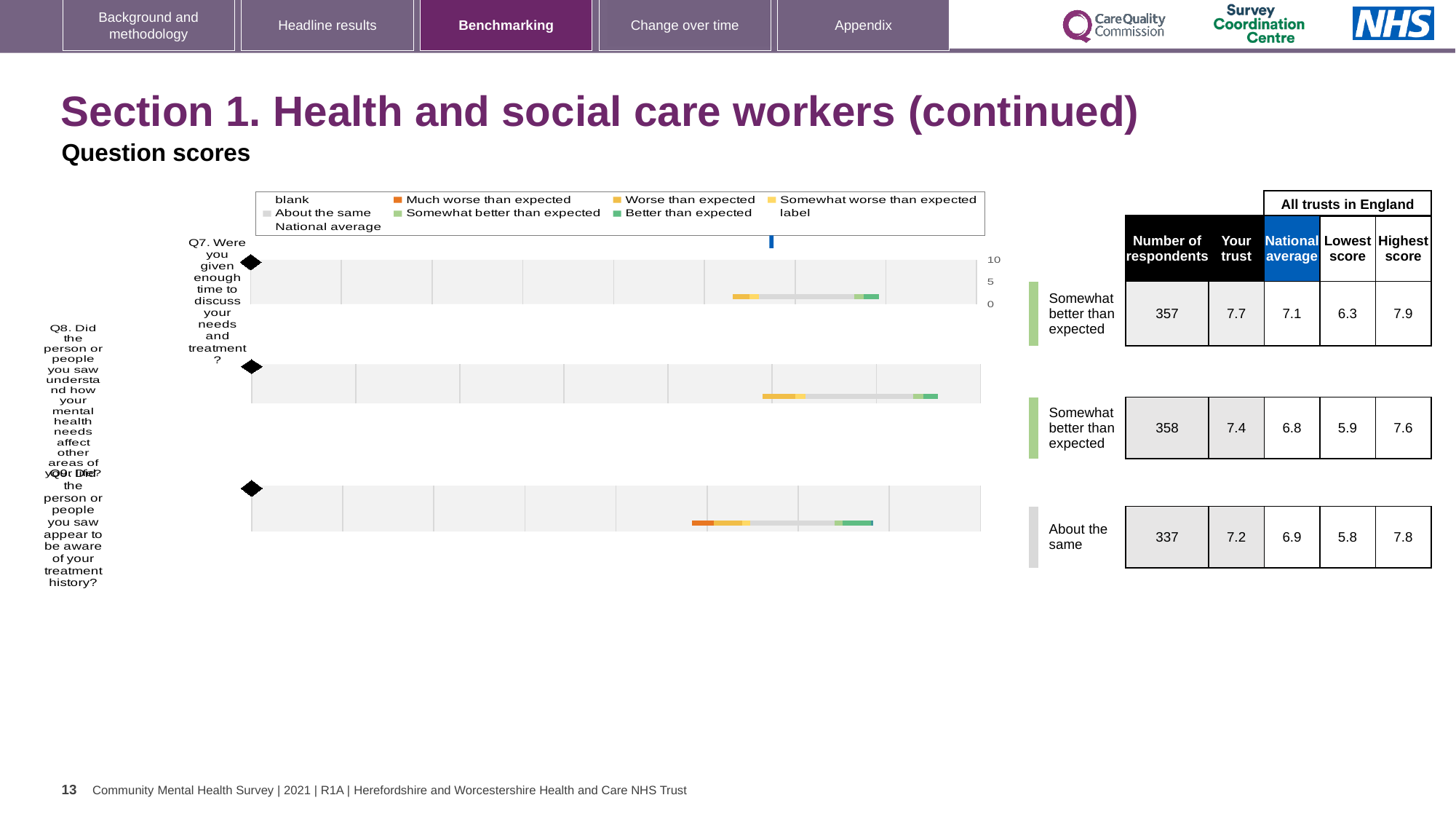
For Q9, which is larger: the 'Your trust' score or the national average? Your trust For Q8, what is the difference between the 'Your trust' score and the national average? 0.6 For Q7 (time to discuss needs and treatment), what is the 'Your trust' score? 7.7 What kind of chart is used to show the question scores for Q7, Q8 and Q9? bar chart Which question has the lowest number of respondents? Q9 For Q8 (understanding how mental health needs affect other areas of life), how many respondents were there? 358 What benchmark category is shown for Q9? About the same Is the 'Your trust' score for Q7 greater or less than 5? greater Which question has the highest 'Your trust' score? Q7 For Q9 (awareness of treatment history), what is the highest score among all trusts in England? 7.8 For Q7, what is the national average score? 7.1 How many questions (Q7, Q8, Q9) are plotted on the slide? 3